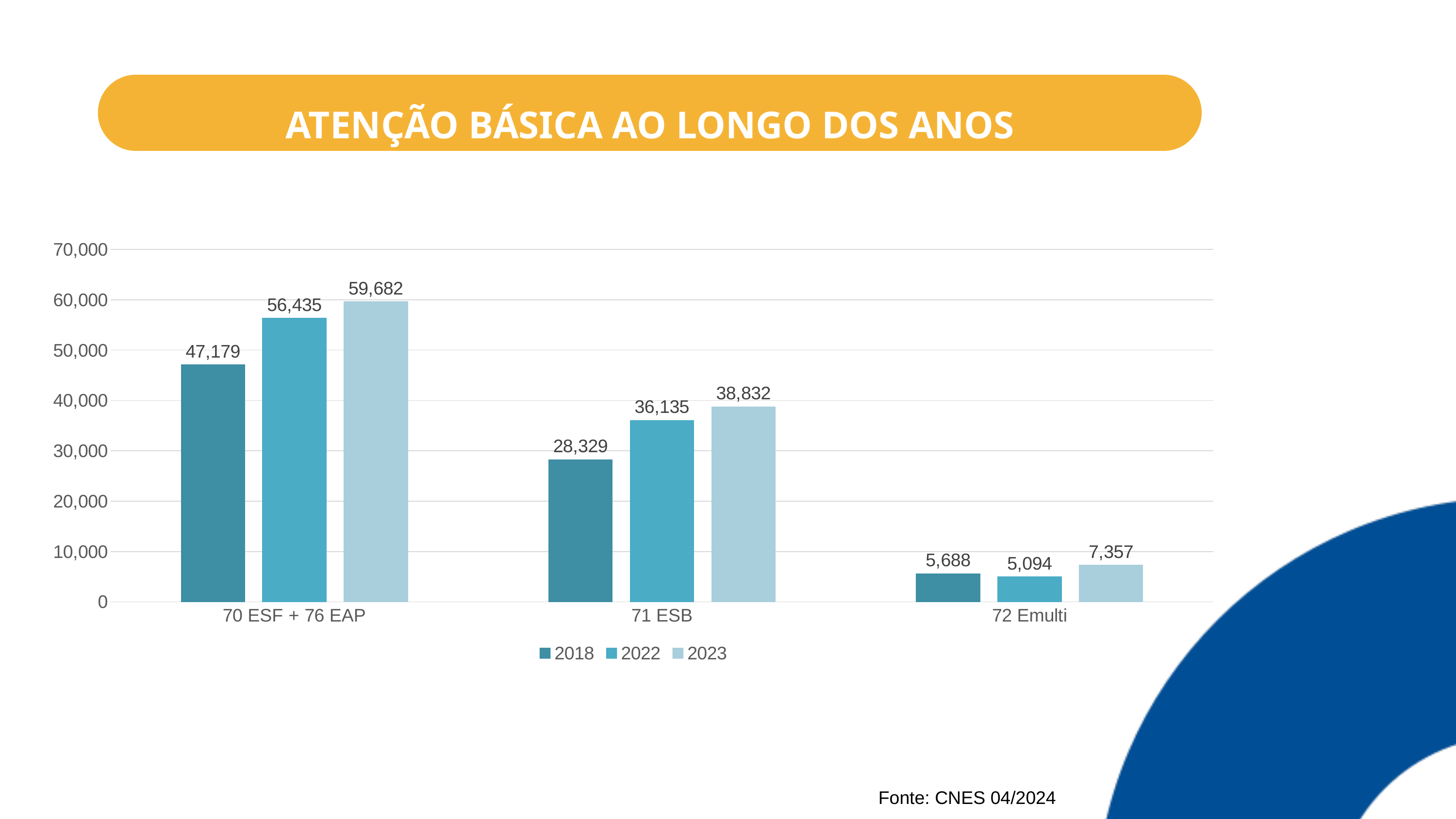
What kind of chart is shown on the slide? Bar chart How many series does the legend list? 3 Which category has the lowest value for 2018? 72 Emulti Which category has the highest value for 2023? 70 ESF + 76 EAP What is the value for 2023 in the 70 ESF + 76 EAP category? 59,682 What is the difference between the 2023 and 2018 values for 71 ESB? 10,503 What is the value for 2018 in the 71 ESB category? 28,329 What is the value for 2022 in the 72 Emulti category? 5,094 Which is larger for 72 Emulti: the 2018 value or the 2022 value? 2018 Is the 2022 value for 71 ESB greater or less than 30,000? greater How many categories are shown on the x axis? 3 What is the difference between the 2022 and 2018 values for 70 ESF + 76 EAP? 9,256